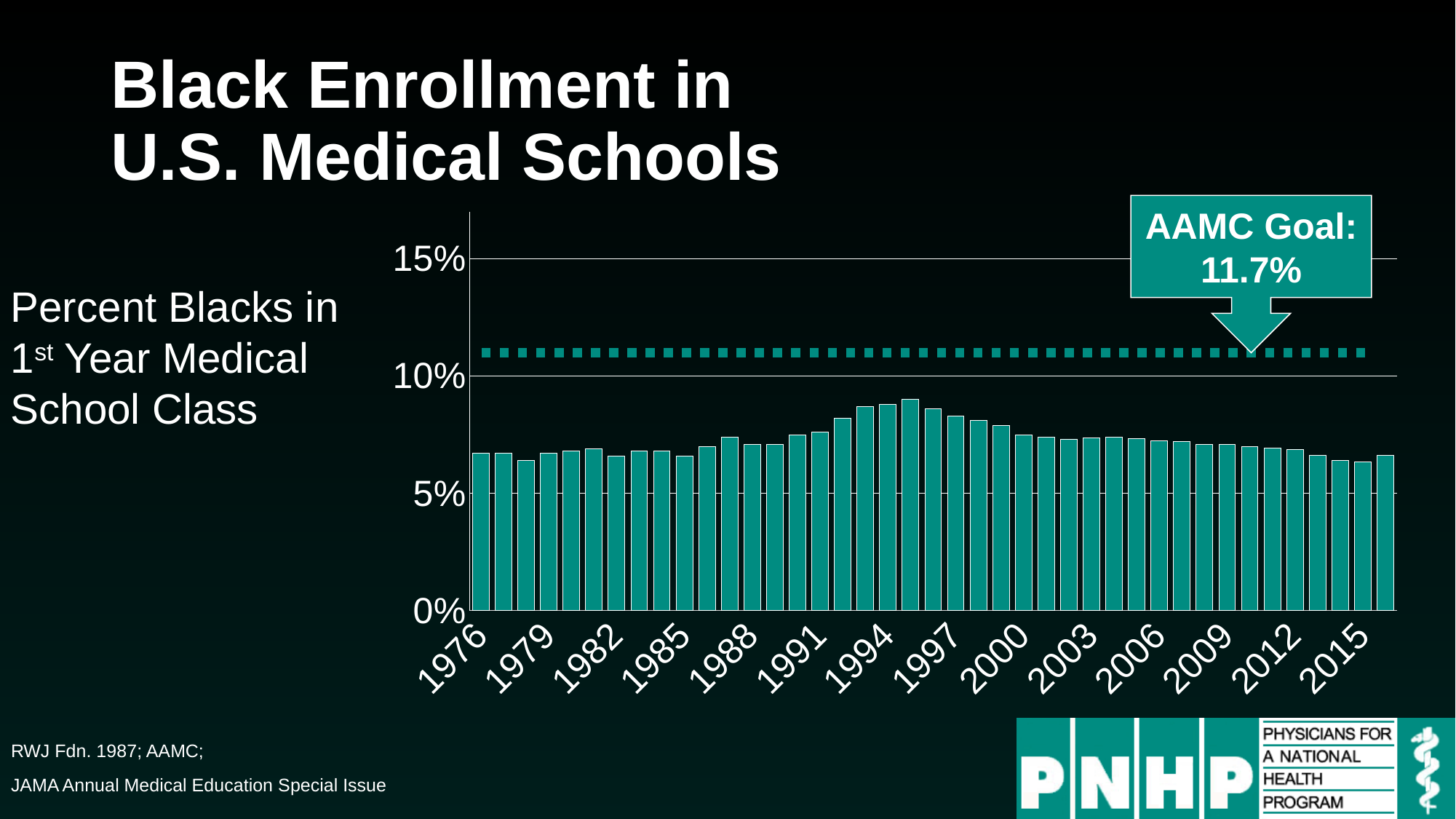
How many years (bars) are plotted on the chart? 41 What does the dashed horizontal line on the chart represent? AAMC Goal: 11.7% What kind of chart is shown on the slide? bar chart Is the value for 1976 greater or less than 5%? greater What is the highest value labelled on the y axis? 15% From the mid-1990s to 2015, do the values generally rise or fall? fall Does the peak of the bars occur before or after 2000? before Is the highest bar on the chart greater or less than 10%? less Do any of the bars reach the dashed AAMC goal line? No Which year has the larger value, 1995 or 2015? 1995 What is the AAMC goal value shown on the chart? 11.7% Which year has the larger value, 1976 or 1994? 1994